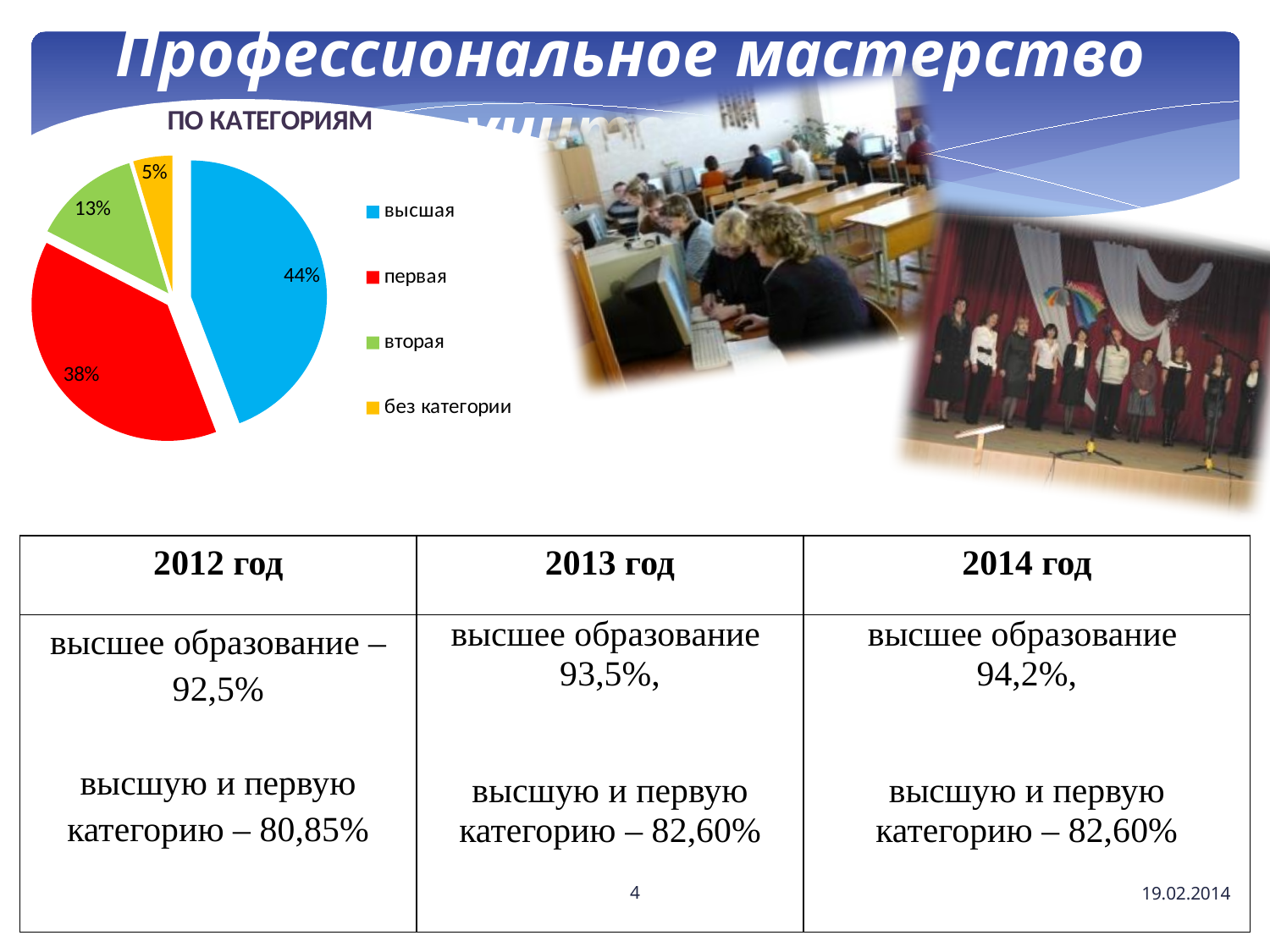
What share of the pie does the "высшая" category have? 44% Which is larger, the share of "вторая" or the share of "без категории"? вторая How many entries does the legend of the pie chart list? 4 Which category has the largest slice of the pie? высшая What share of the pie does the "без категории" category have? 5% How many categories does the pie chart show? 4 Which category has the smallest slice of the pie? без категории What share of the pie does the "первая" category have? 38% What is the difference between the shares of "высшая" and "первая"? 6% What kind of chart is shown on the slide? pie chart What is the title of the pie chart? ПО КАТЕГОРИЯМ